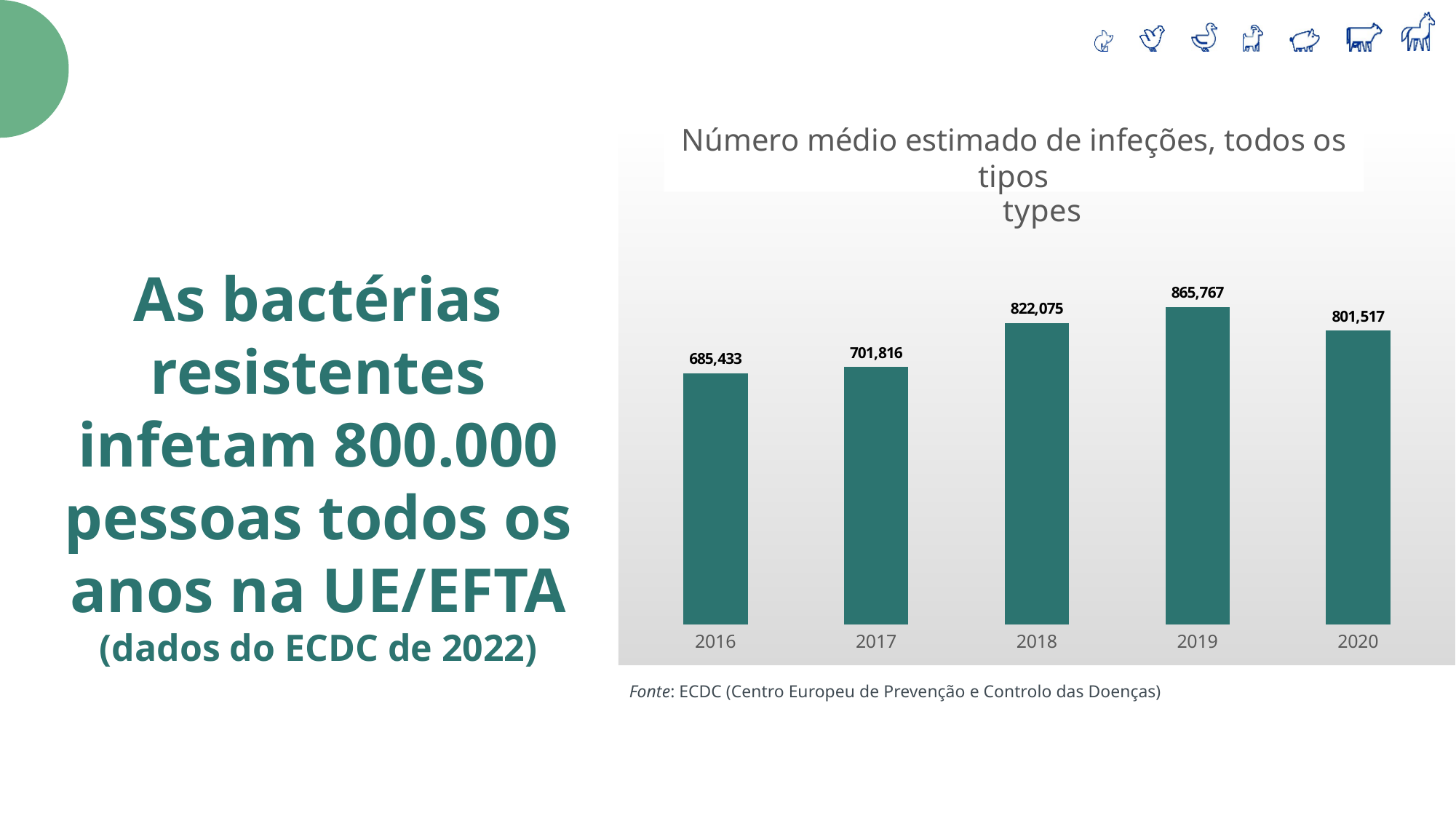
What is the value for 2019? 865,767 Which year has the highest value? 2019 What is the source cited below the chart? ECDC (Centro Europeu de Prevenção e Controlo das Doenças) Which year has the lowest value? 2016 What is the value for 2016? 685,433 What is the difference between the values for 2019 and 2020? 64,250 Which is larger, the value for 2018 or the value for 2020? 2018 What is the difference between the values for 2019 and 2016? 180,334 Do the values rise or fall from 2016 to 2019? rise What kind of chart is shown? bar chart How many years are shown on the x axis? 5 What is the value for 2020? 801,517